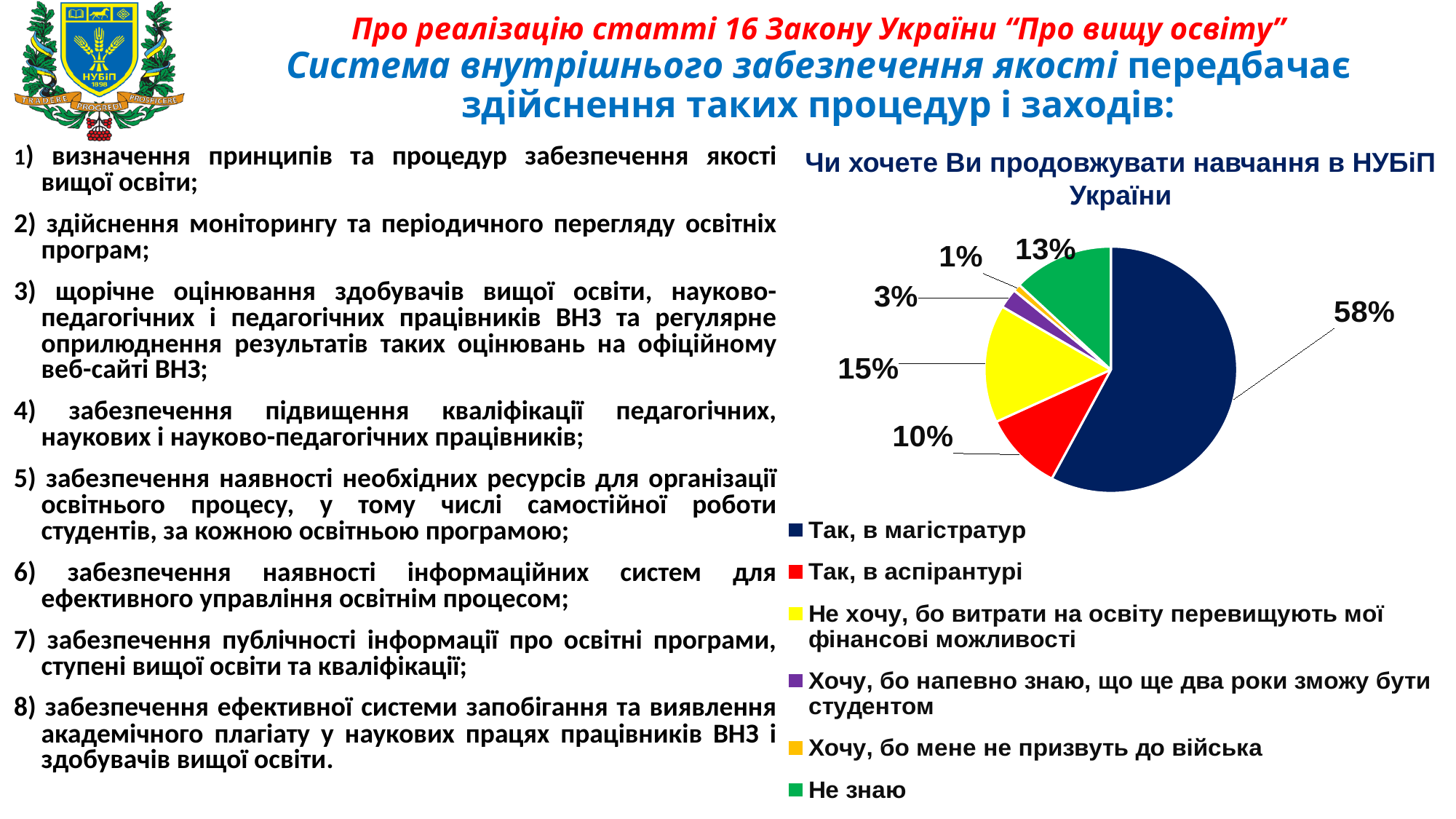
What share of respondents answered "Не знаю"? 13% Which answer has the largest share of the pie? Так, в магістратур What share of respondents answered "Так, в магістратур"? 58% What is the difference in percentage points between "Так, в магістратур" and "Так, в аспірантурі"? 48 How many slices does the pie chart have? 6 Which is larger: the share for "Не знаю" or the share for "Так, в аспірантурі"? Не знаю What share of respondents answered "Так, в аспірантурі"? 10% What share of respondents answered "Хочу, бо напевно знаю, що ще два роки зможу бути студентом"? 3% What share of respondents answered "Хочу, бо мене не призвуть до війська"? 1% Which answer has the smallest share of the pie? Хочу, бо мене не призвуть до війська What kind of chart is shown on the slide? pie chart What colour is the slice for "Не хочу, бо витрати на освіту перевищують мої фінансові можливості"? yellow